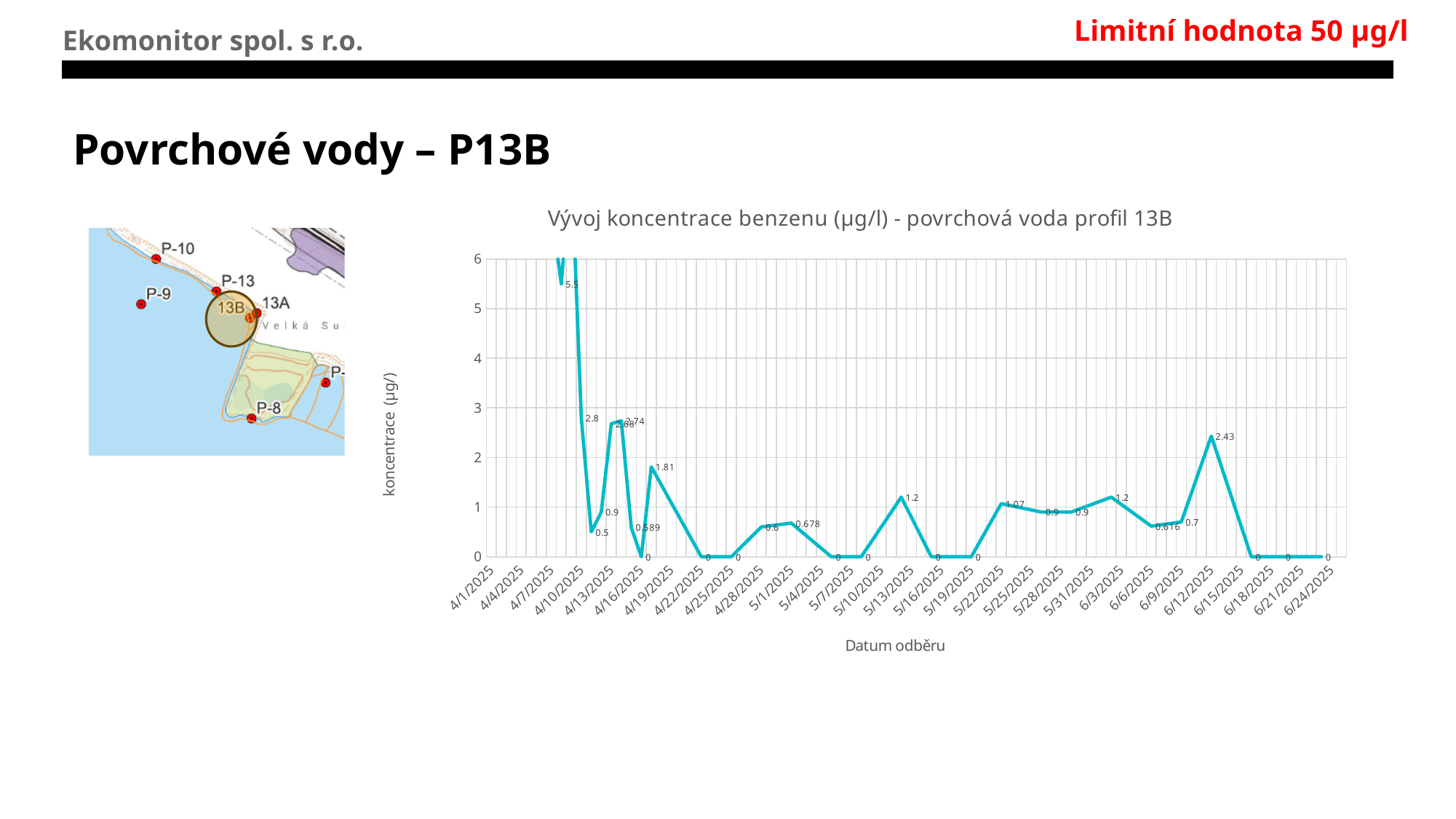
What kind of chart is shown on the slide? line chart What is the title of the chart? Vývoj koncentrace benzenu (µg/l) - povrchová voda profil 13B Is the value for 6/12/2025 greater or less than 2? greater Overall, do the plotted values rise or fall from the beginning of April to the end of June? fall What is the label of the vertical axis of the chart? koncentrace (µg/l) What is the benzene concentration value plotted for 6/12/2025? 2.43 What is the lowest value plotted on the chart? 0 What is the highest tick value shown on the vertical axis? 6